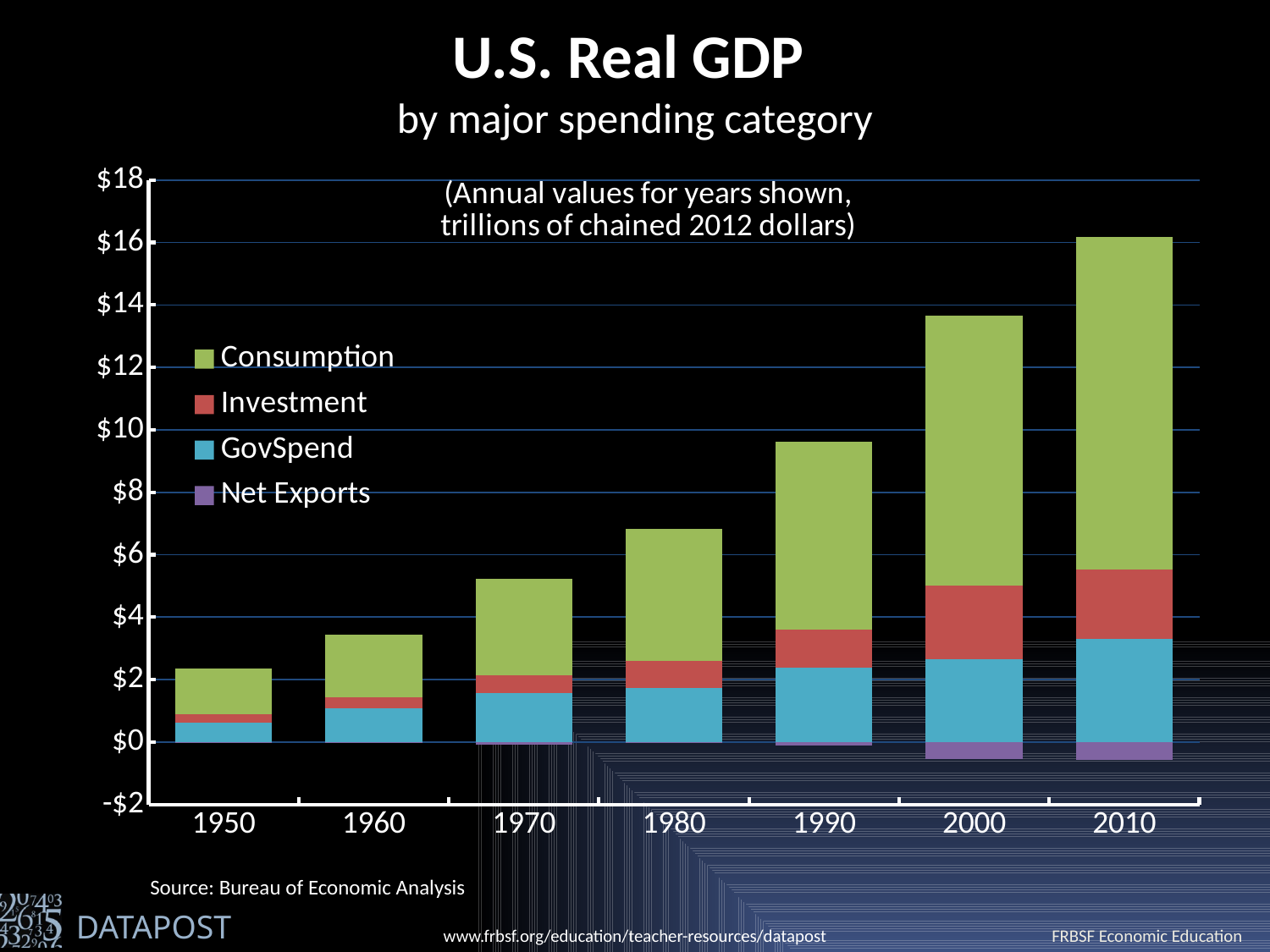
How many years are shown on the x axis of the chart? 7 Which year has a taller total bar, 1990 or 2000? 2000 Is the total bar height for 1960 greater or less than $4? less What kind of chart is shown on the slide? Stacked bar chart What is the source cited for the chart's data? Bureau of Economic Analysis Do the total bar heights rise or fall from 1950 to 2010? Rise Is the total bar height for 1980 greater or less than $6? greater Which year has the tallest total bar in the chart? 2010 Is the total bar height for 2010 greater or less than $14? greater Which spending category is shown in green in the chart? Consumption How many series does the chart's legend list? 4 Which year has the shortest total bar in the chart? 1950